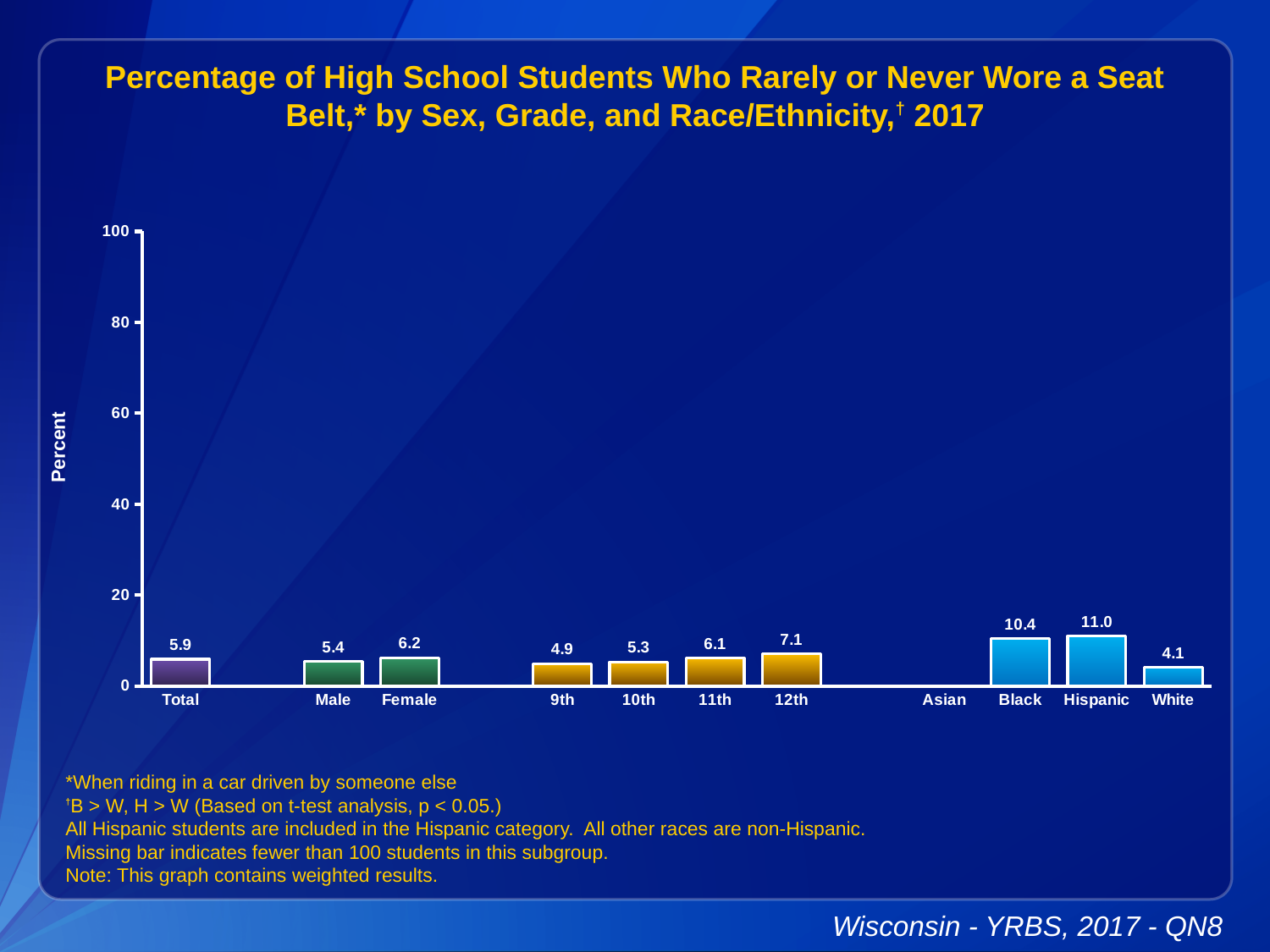
Is the value for Hispanic greater or less than 20? less What is the difference between the Female and Male values? 0.8 Which is larger, the value for 9th grade or the value for 11th grade? 11th What is the value for Total? 5.9 Which category has the highest value? Hispanic What is the value for 12th grade? 7.1 What is the value for Female? 6.2 What kind of chart is shown on the slide? bar chart Do the values rise or fall from 9th grade to 12th grade? rise What is the value for Hispanic? 11.0 What is the difference between the Black and White values? 6.3 Which category has the lowest value among those with a bar shown? White